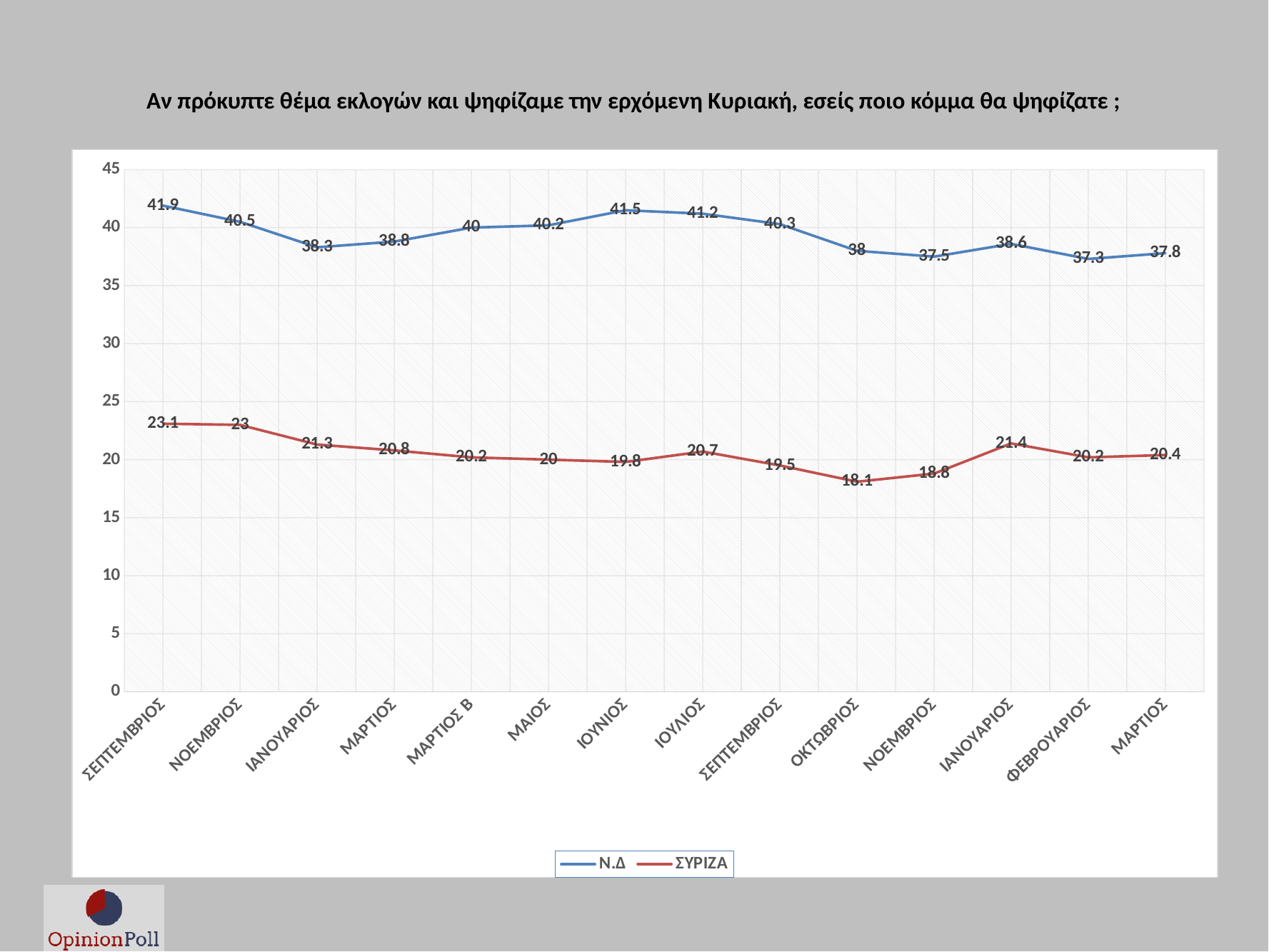
In which month does ΣΥΡΙΖΑ reach its lowest value? ΟΚΤΩΒΡΙΟΣ Is the value for ΣΥΡΙΖΑ in ΟΚΤΩΒΡΙΟΣ greater or less than 20? less What is the value for Ν.Δ in ΦΕΒΡΟΥΑΡΙΟΣ? 37.3 Which is larger, the ΣΥΡΙΖΑ value in ΜΑΙΟΣ or in ΙΟΥΛΙΟΣ? ΙΟΥΛΙΟΣ Which colour is used for the ΣΥΡΙΖΑ line? Red What is the value for Ν.Δ in ΙΟΥΝΙΟΣ? 41.5 What kind of chart is shown on the slide? Line chart How many series does the legend list? 2 What is the difference between Ν.Δ and ΣΥΡΙΖΑ in ΙΟΥΝΙΟΣ? 21.7 What is the value for ΣΥΡΙΖΑ in ΟΚΤΩΒΡΙΟΣ? 18.1 What is the highest value plotted for Ν.Δ? 41.9 How many points are plotted along the x axis for each series? 14